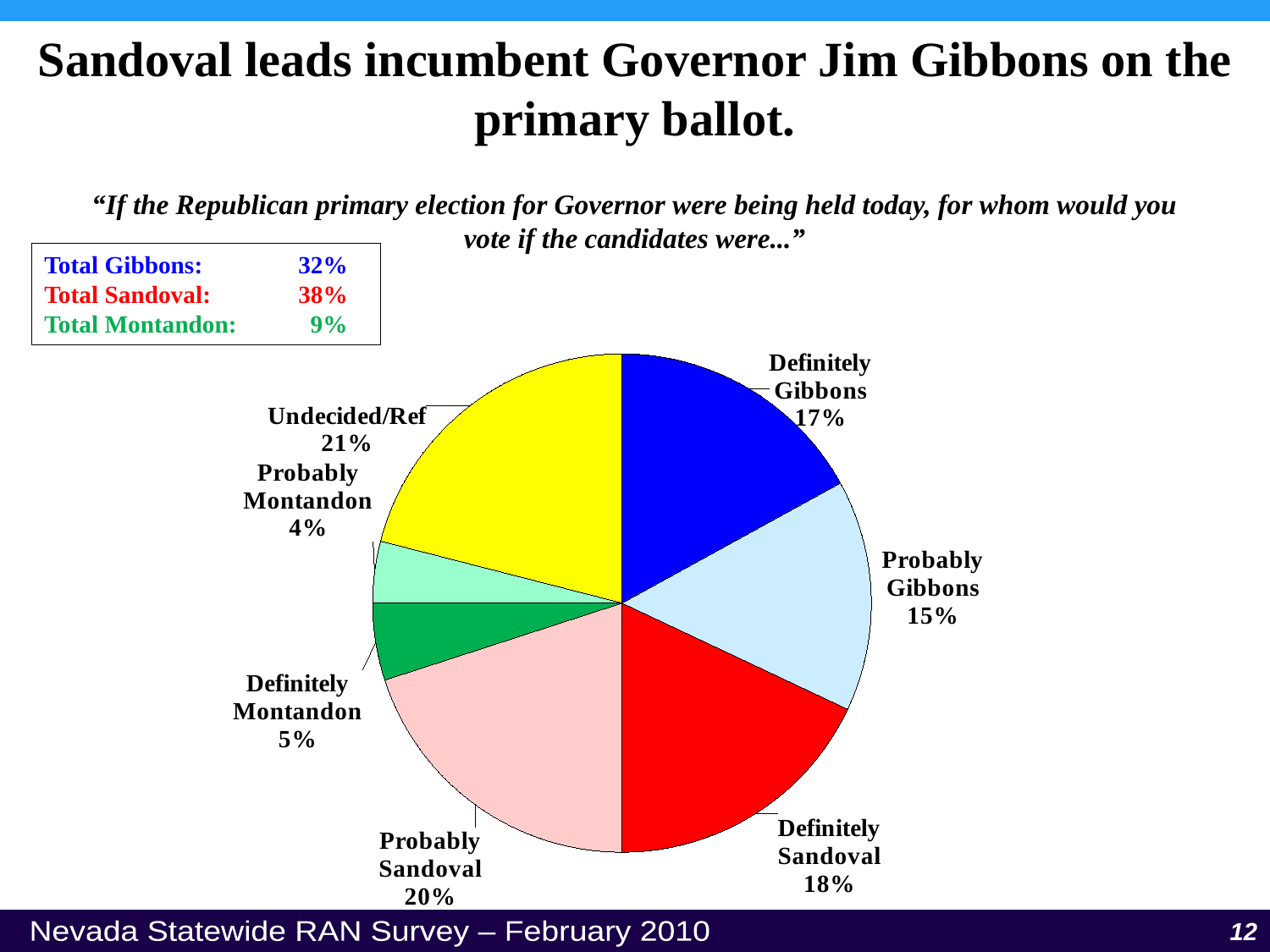
What percentage of respondents said Probably Sandoval? 20% What colour is the Definitely Sandoval slice? red Which is larger, Probably Sandoval or Probably Gibbons? Probably Sandoval What percentage of respondents said Definitely Gibbons? 17% What kind of chart is shown on the slide? pie chart What percentage of respondents said Definitely Montandon? 5% Which slice of the pie is the smallest? Probably Montandon What is the combined share of Definitely Montandon and Probably Montandon? 9% What is the value for the Undecided/Ref slice? 21% What is the difference between Definitely Sandoval and Definitely Gibbons? 1% Which slice of the pie is the largest? Undecided/Ref How many slices does the pie chart have? 7